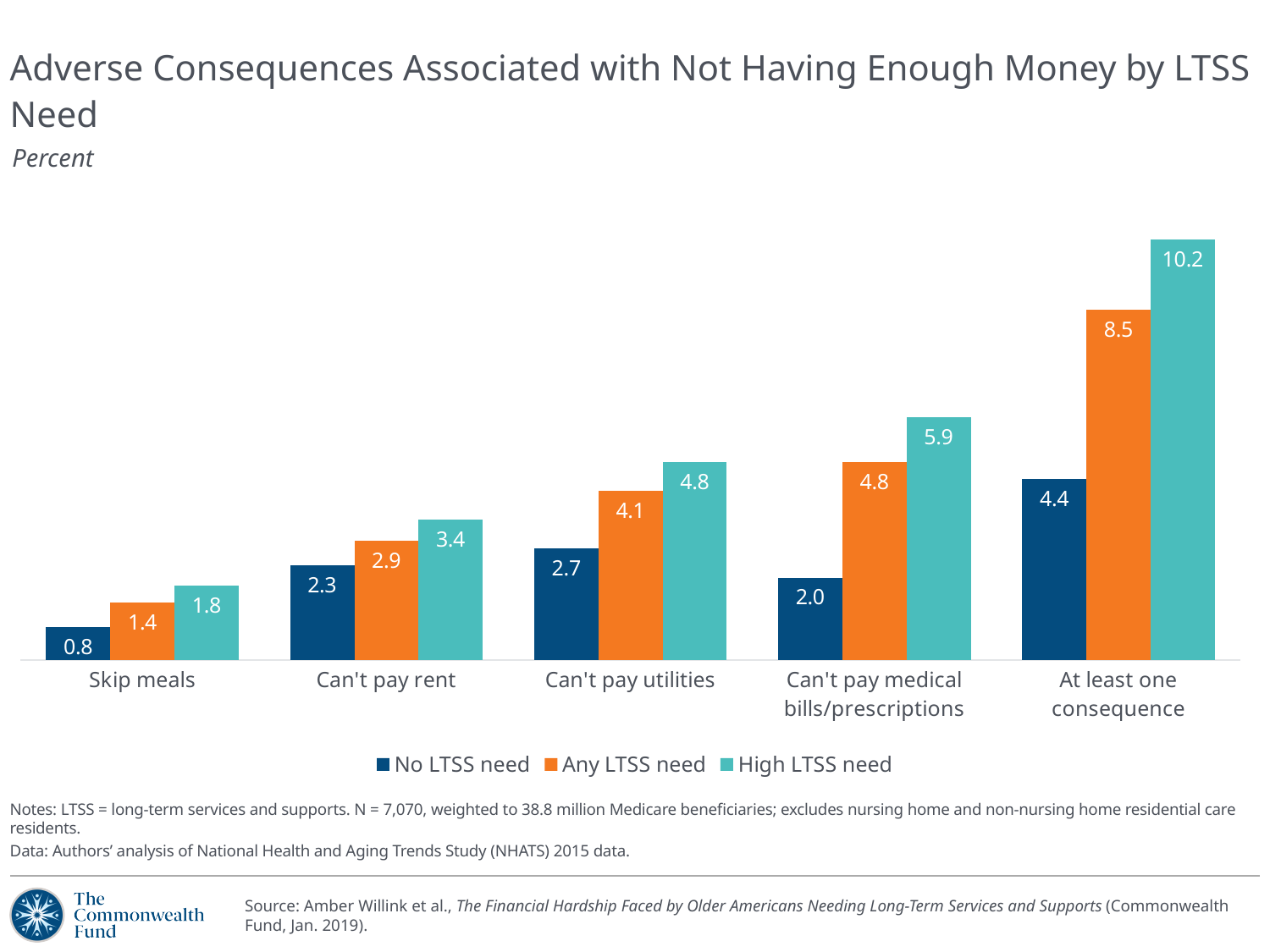
What is the value for No LTSS need in the 'Can't pay utilities' category? 2.7 What is the value for High LTSS need in the 'At least one consequence' category? 10.2 What is the difference between the High LTSS need and No LTSS need values for 'Can't pay medical bills/prescriptions'? 3.9 Which category has the highest value for the Any LTSS need series? At least one consequence How many categories are shown on the x axis? 5 What kind of chart is shown on the slide? Bar chart Which series is shown in orange in the legend? Any LTSS need How many series does the legend list? 3 What is the value for Any LTSS need in the 'Skip meals' category? 1.4 Which category has the lowest value for the No LTSS need series? Skip meals Do the High LTSS need values rise or fall from 'Skip meals' to 'At least one consequence'? Rise Which is larger: the No LTSS need value for 'Can't pay rent' or the No LTSS need value for 'Can't pay utilities'? Can't pay utilities